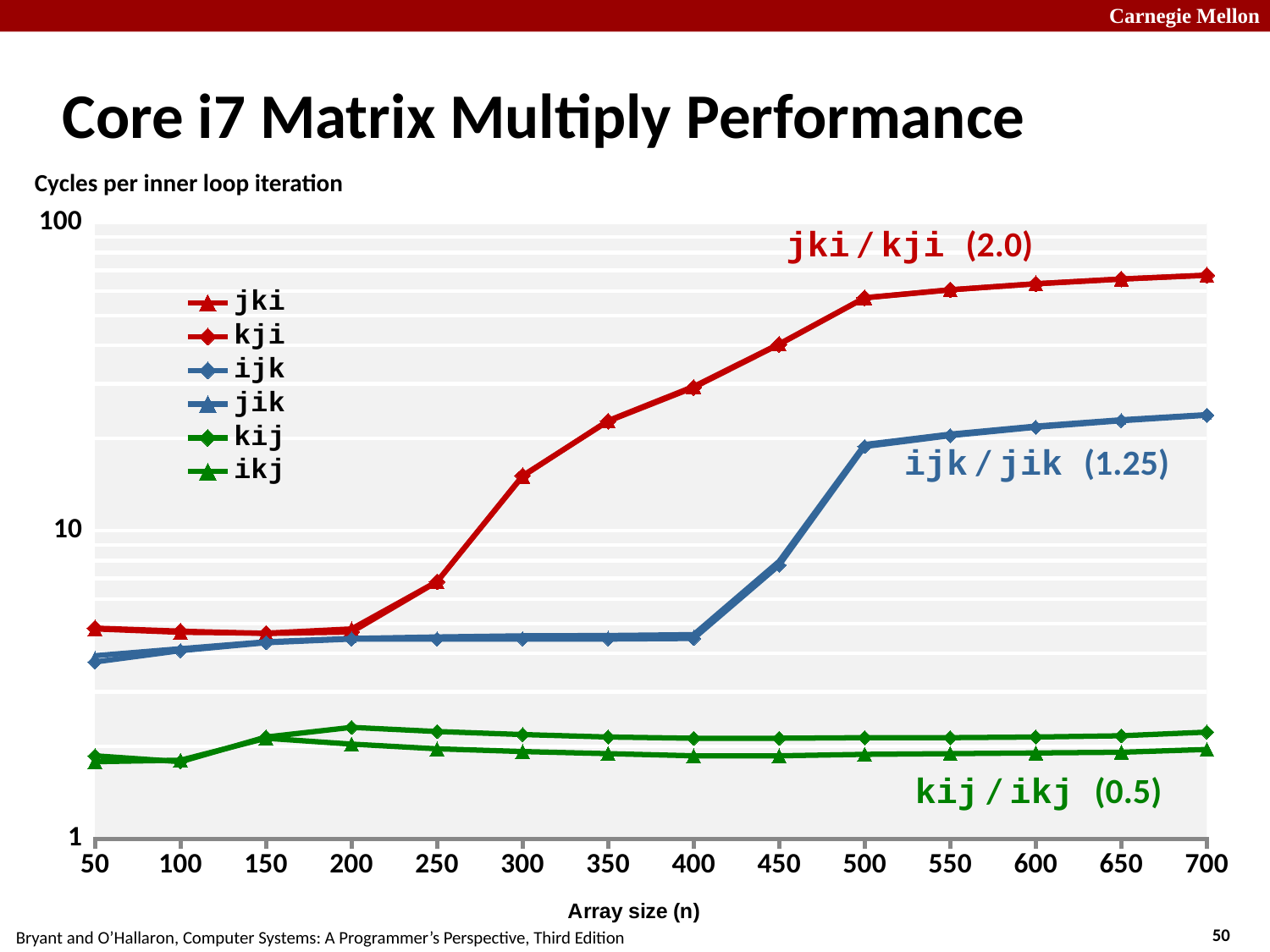
At array size 700, which is larger, the value for jki or the value for ijk? jki Is the value for ijk at array size 600 greater or less than 10? greater At array size 700, which is larger, the value for kij or the value for ijk? ijk Do the values for jki rise or fall as the array size increases from 50 to 700? rise Is the value for ijk at array size 400 greater or less than 10? less Is the value for jki at array size 50 greater or less than 10? less What kind of chart is shown on the slide? line chart What is the label of the x axis? Array size (n) How many array size values are marked along the x axis? 14 How many series does the legend list? 6